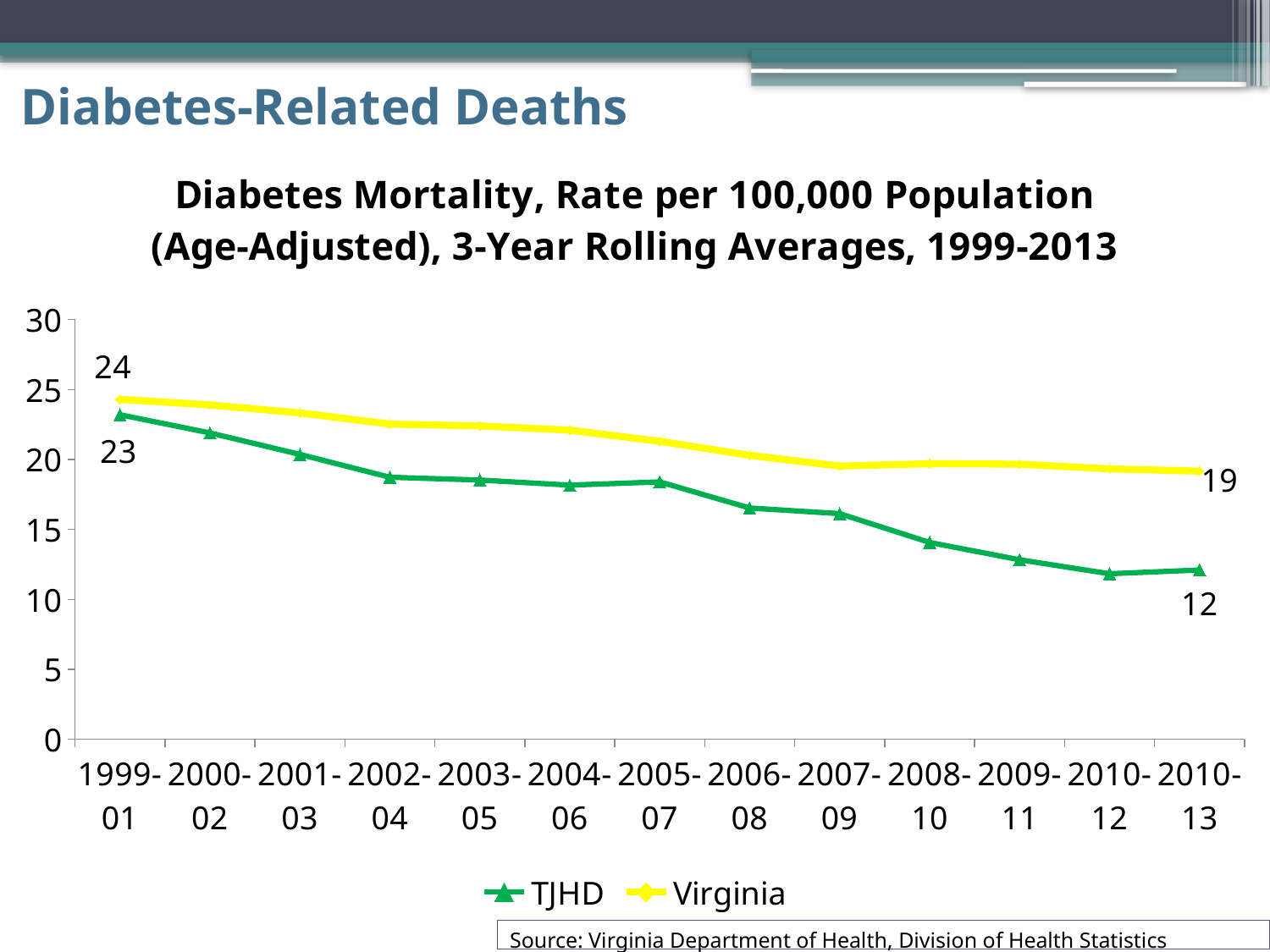
Which series has the higher value in 2010-13, TJHD or Virginia? Virginia What is the Virginia value for 1999-01? 24 What is the Virginia value for the last period, 2010-13? 19 How many time periods are shown on the x axis? 13 What is the difference between the Virginia and TJHD values for 2010-13? 7 Do the TJHD values rise or fall over the periods shown? fall What is the TJHD value for 1999-01? 23 What type of chart is shown on the slide? line chart By how much did the TJHD value fall from 1999-01 to 2010-13? 11 Is the TJHD value for 2005-07 greater or less than 20? less What is the TJHD value for the last period, 2010-13? 12 How many series does the legend list? 2